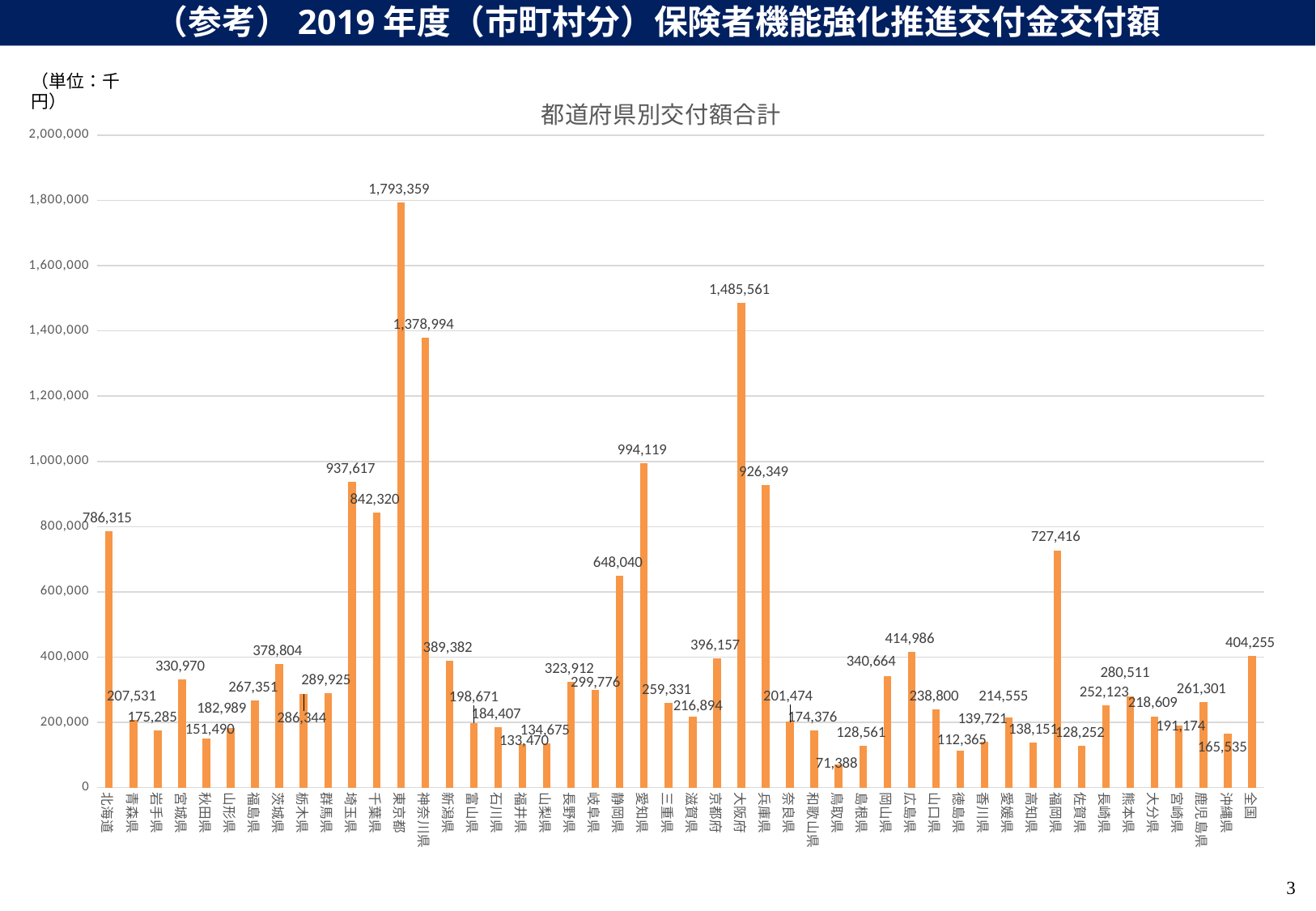
What is the value for 東京都? 1,793,359 Which category has the highest value? 東京都 What kind of chart is shown on the slide? bar chart Which is larger, the value for 愛知県 or the value for 静岡県? 愛知県 What is the value for 全国? 404,255 What is the difference between the values for 東京都 and 大阪府? 307,798 What is the title of the chart? 都道府県別交付額合計 How many bars are plotted in the chart? 48 Which category has the lowest value? 鳥取県 Is the value for 神奈川県 greater or less than 1,200,000? greater What is the value for 大阪府? 1,485,561 What is the value for 鳥取県? 71,388